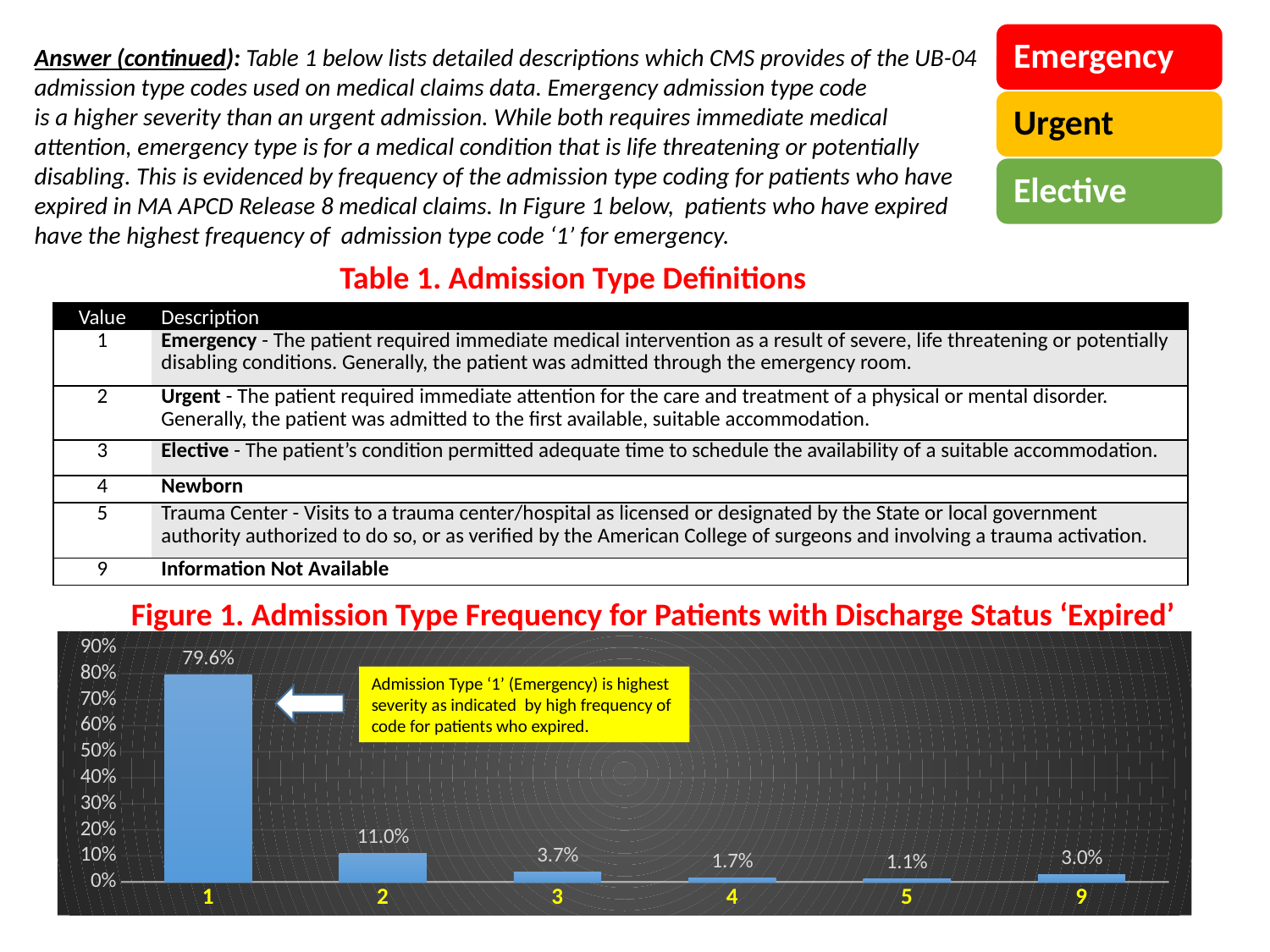
What is the value for admission type code 2 in Figure 1? 11.0% What is the value for admission type code 1 in Figure 1? 79.6% Which has a larger value in Figure 1, admission type code 4 or code 9? 9 Which admission type code has the lowest frequency in Figure 1? 5 What is the difference between the values for admission type codes 3 and 9 in Figure 1? 0.7% What is the difference between the values for admission type codes 1 and 2 in Figure 1? 68.6% How many admission type codes are shown on the x axis of Figure 1? 6 Which admission type code has the highest frequency in Figure 1? 1 What kind of chart is Figure 1? bar chart What is the value for admission type code 9 in Figure 1? 3.0% Is the value for admission type code 2 in Figure 1 greater or less than 20%? less What is the title of the chart at the bottom of the slide? Figure 1. Admission Type Frequency for Patients with Discharge Status 'Expired'